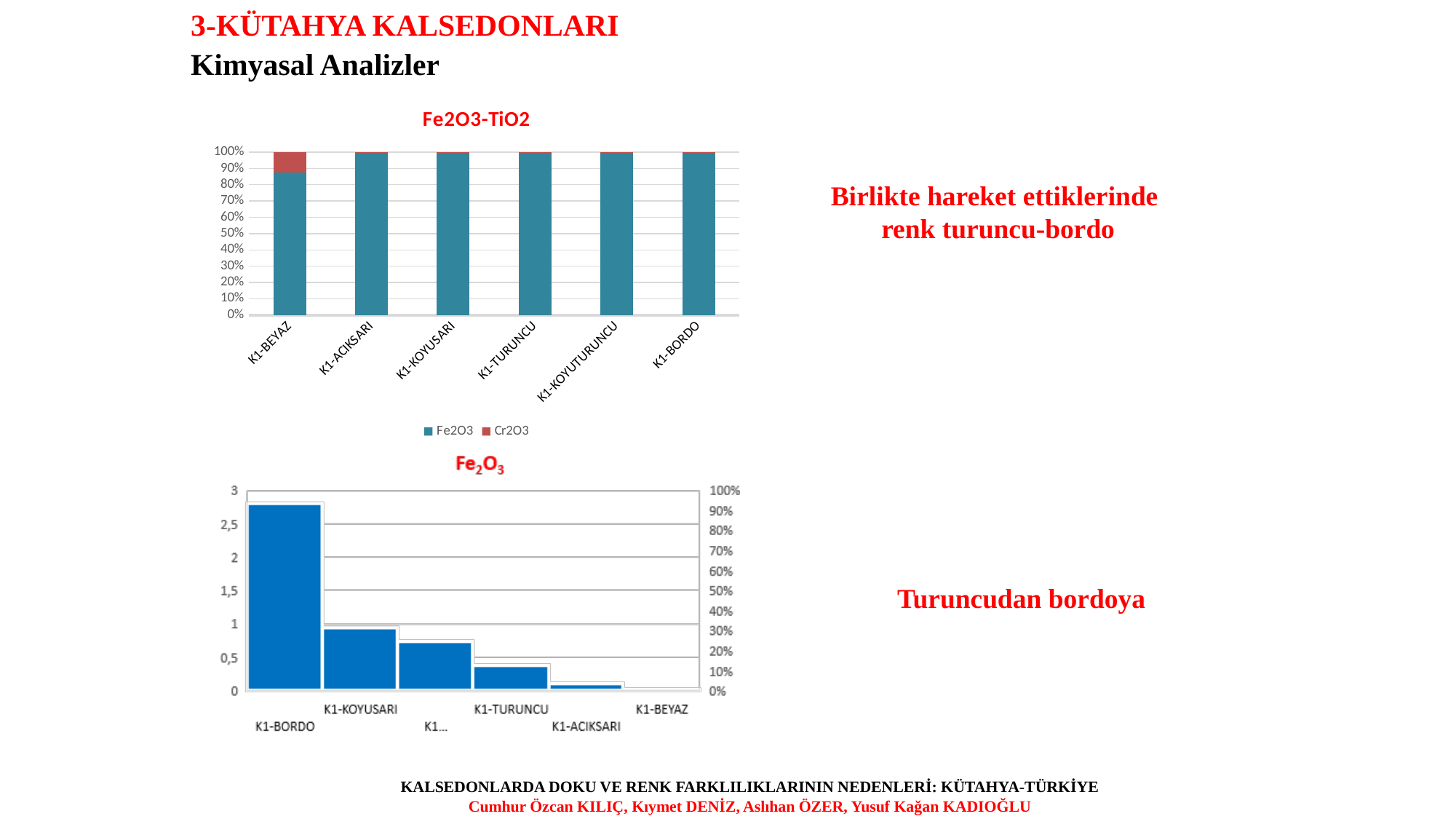
In the top chart (Fe2O3-TiO2), is the Fe2O3 share for K1-BEYAZ greater or less than 80%? greater What kind of chart is the top chart titled Fe2O3-TiO2? bar chart In the bottom chart (Fe2O3), is the value for K1-TURUNCU greater or less than 0.5? less In the bottom chart (Fe2O3), which category has the highest value? K1-BORDO How many series does the legend of the top chart (Fe2O3-TiO2) list? 2 In the top chart (Fe2O3-TiO2), which category is the only one with a visible Cr2O3 segment? K1-BEYAZ In the bottom chart (Fe2O3), which category has the lowest value? K1-BEYAZ How many categories are shown on the x axis of the top chart (Fe2O3-TiO2)? 6 What kind of chart is the bottom chart titled Fe2O3? bar chart In the bottom chart (Fe2O3), do the values rise or fall from left to right along the x axis? fall In the bottom chart (Fe2O3), is the value for K1-BORDO greater or less than 2.5? greater What are the two series named in the legend of the top chart (Fe2O3-TiO2)? Fe2O3 and Cr2O3